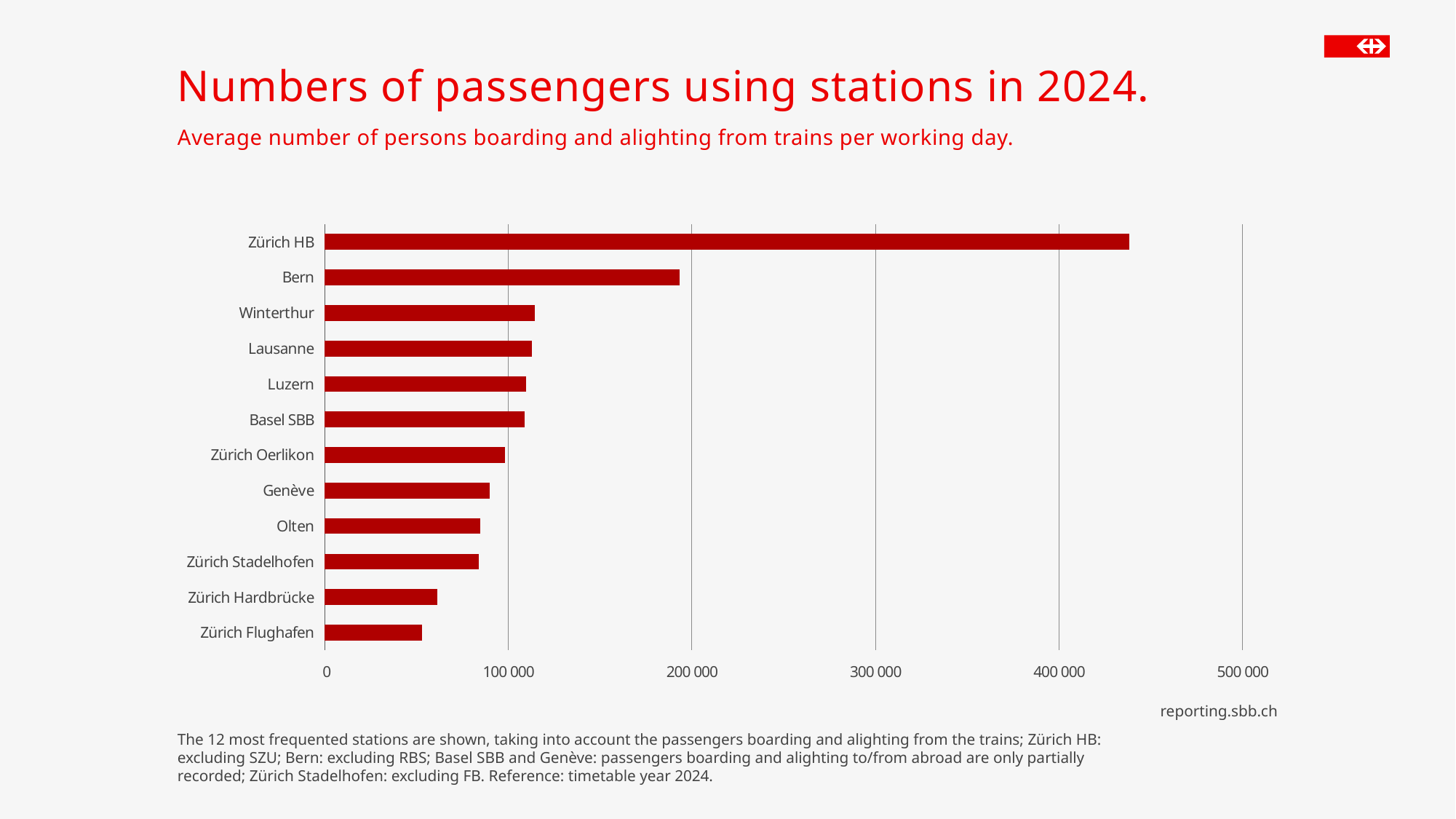
Is the value for Zürich HB greater or less than 400 000? greater Which has more passengers, Zürich Hardbrücke or Zürich Flughafen? Zürich Hardbrücke Which station has the lowest number of passengers? Zürich Flughafen Which station has the highest number of passengers? Zürich HB Is the value for Winterthur greater or less than 100 000? greater Which has more passengers, Bern or Winterthur? Bern What kind of chart is shown on the slide? Bar chart How many stations are shown in the chart? 12 Is the value for Genève greater or less than 100 000? less What is the highest value shown on the horizontal axis? 500 000 What is the title of the slide? Numbers of passengers using stations in 2024.